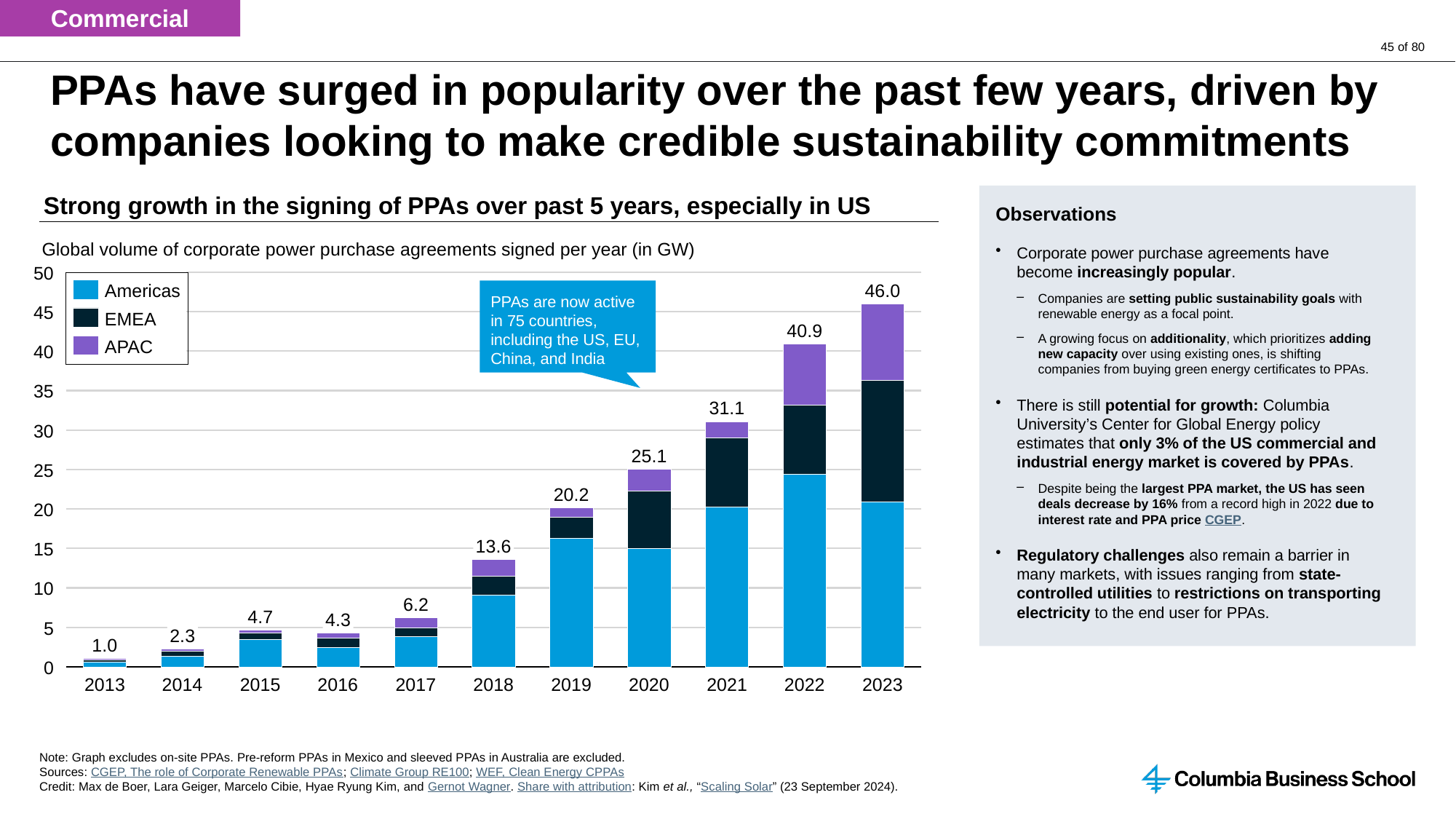
How many years are shown on the x axis of the chart? 11 What kind of chart is used to show the global volume of corporate PPAs? Stacked bar chart Is the value for Americas in 2022 greater or less than 20? greater How many series does the chart legend list? 3 Which year has the highest total volume of PPAs signed? 2023 What is the total global volume of corporate PPAs signed in 2023? 46.0 Which region is shown in purple in the chart legend? APAC What is the difference between the total for 2023 and the total for 2022? 5.1 Which year has a larger total, 2015 or 2016? 2015 What is the total value shown for 2018? 13.6 Which year has the lowest total volume of PPAs signed? 2013 What is the total value shown for 2020? 25.1